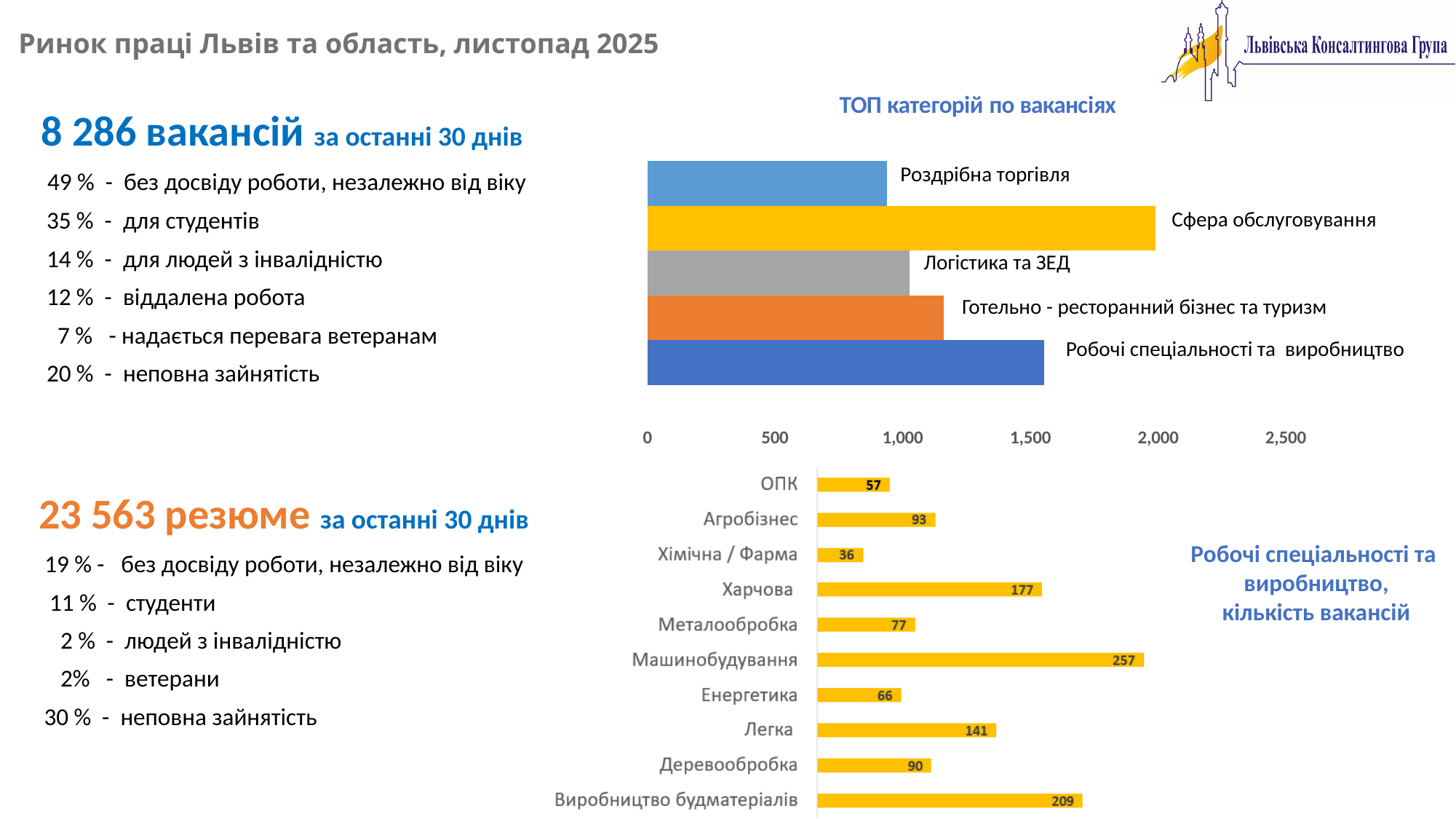
In the chart 'ТОП категорій по вакансіях', is the value for Робочі спеціальності та виробництво greater or less than 1,500? greater In the chart 'Робочі спеціальності та виробництво, кількість вакансій', which category has the lowest value? Хімічна / Фарма In the chart 'Робочі спеціальності та виробництво, кількість вакансій', which is larger: Харчова or Легка? Харчова In the chart 'Робочі спеціальності та виробництво, кількість вакансій', what is the value for Хімічна / Фарма? 36 In the chart 'ТОП категорій по вакансіях', is the value for Роздрібна торгівля greater or less than 1,000? less How many categories are shown in the chart 'Робочі спеціальності та виробництво, кількість вакансій'? 10 In the chart 'Робочі спеціальності та виробництво, кількість вакансій', what is the difference between Машинобудування and Виробництво будматеріалів? 48 What type of chart is 'ТОП категорій по вакансіях'? bar chart How many categories are shown in the chart 'ТОП категорій по вакансіях'? 5 In the chart 'ТОП категорій по вакансіях', which category has the longest bar? Сфера обслуговування In the chart 'Робочі спеціальності та виробництво, кількість вакансій', what is the value for Машинобудування? 257 In the chart 'ТОП категорій по вакансіях', is the value for Сфера обслуговування greater or less than 1,500? greater